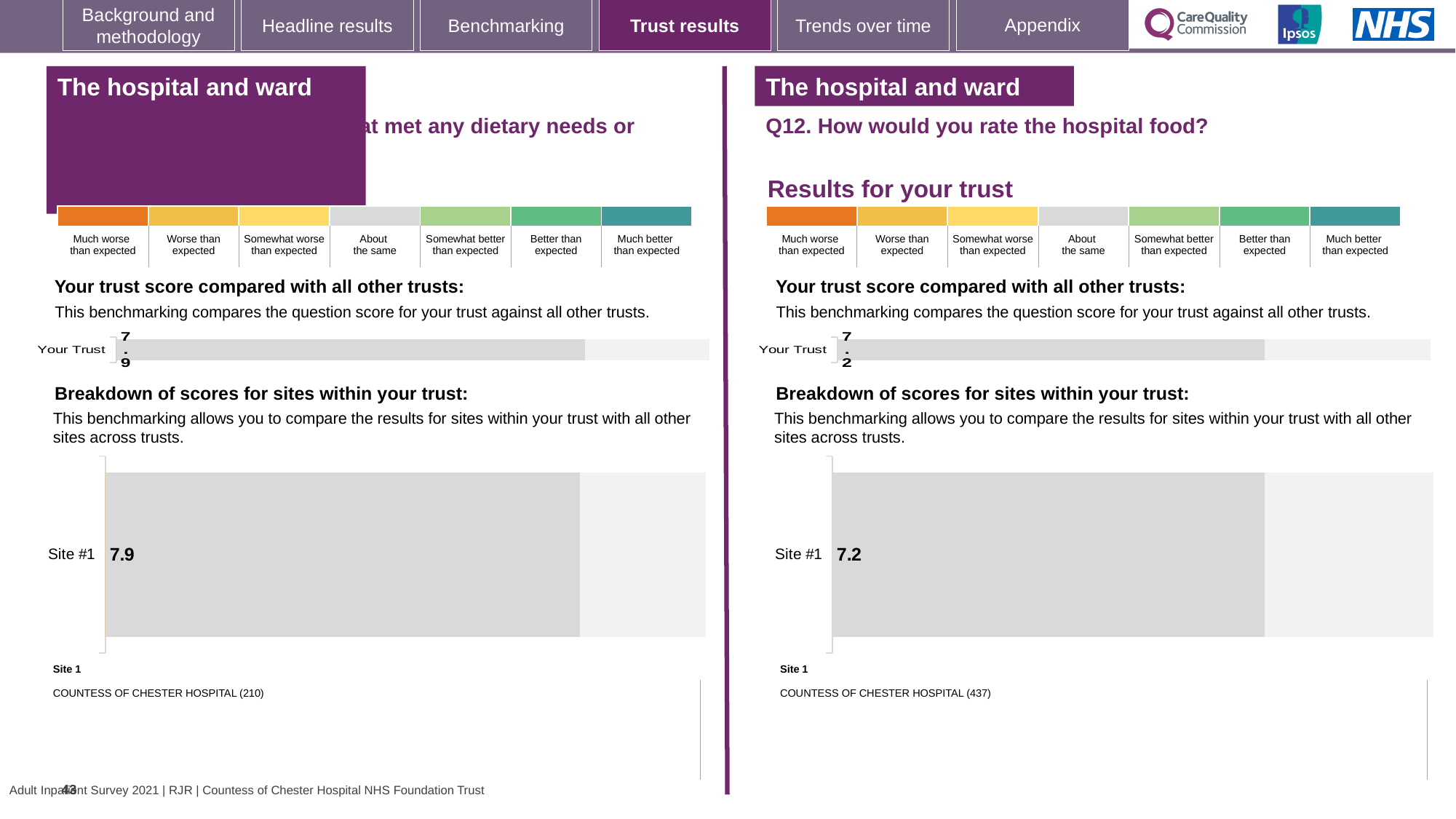
Which is larger: the Site #1 score on the left-hand chart or the Site #1 score on the right-hand Q12 chart? Left-hand chart (7.9) How many sites are shown in the site breakdown chart on the right-hand Q12 side? 1 On the right-hand chart for Q12 (How would you rate the hospital food?), what is the score shown for Your Trust? 7.2 What is the difference between the Site #1 score on the left-hand chart and the Site #1 score on the right-hand Q12 chart? 0.7 What is the name of Site 1 listed under the right-hand Q12 chart? COUNTESS OF CHESTER HOSPITAL (437) What kind of chart is used to show the Site #1 score on the right-hand Q12 side? Bar chart On the right-hand chart for Q12, what is the score shown for Site #1? 7.2 What is the name of Site 1 listed under the left-hand chart? COUNTESS OF CHESTER HOSPITAL (210) How many sites are shown in the site breakdown chart on the left-hand side? 1 On the left-hand chart (the dietary needs question), what is the score shown for Site #1? 7.9 On the left-hand chart (the dietary needs question), what is the score shown for Your Trust? 7.9